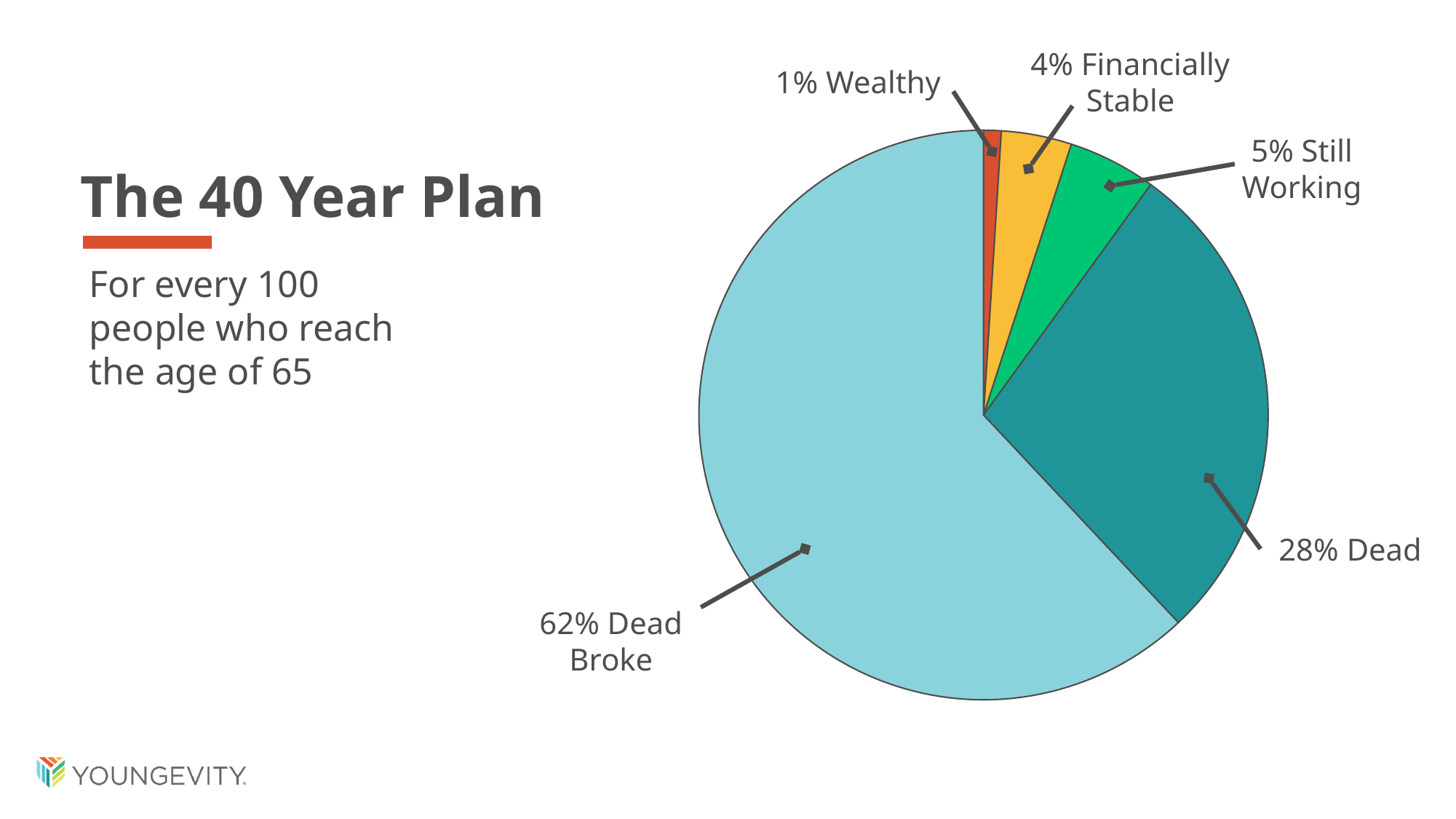
What kind of chart is shown on the slide? Pie chart What percentage of people are labelled as Wealthy? 1% What is the title of the slide containing the pie chart? The 40 Year Plan What is the difference in percentage points between Dead Broke and Dead? 34 What percentage of people are labelled as Dead? 28% What percentage of people are labelled as Dead Broke? 62% Which category has the smallest share of the pie? Wealthy How many slices does the pie chart have? 5 Which category has the largest share of the pie? Dead Broke What percentage of people are labelled as Still Working? 5% What percentage of people are labelled as Financially Stable? 4% Which is larger, the share for Still Working or the share for Financially Stable? Still Working